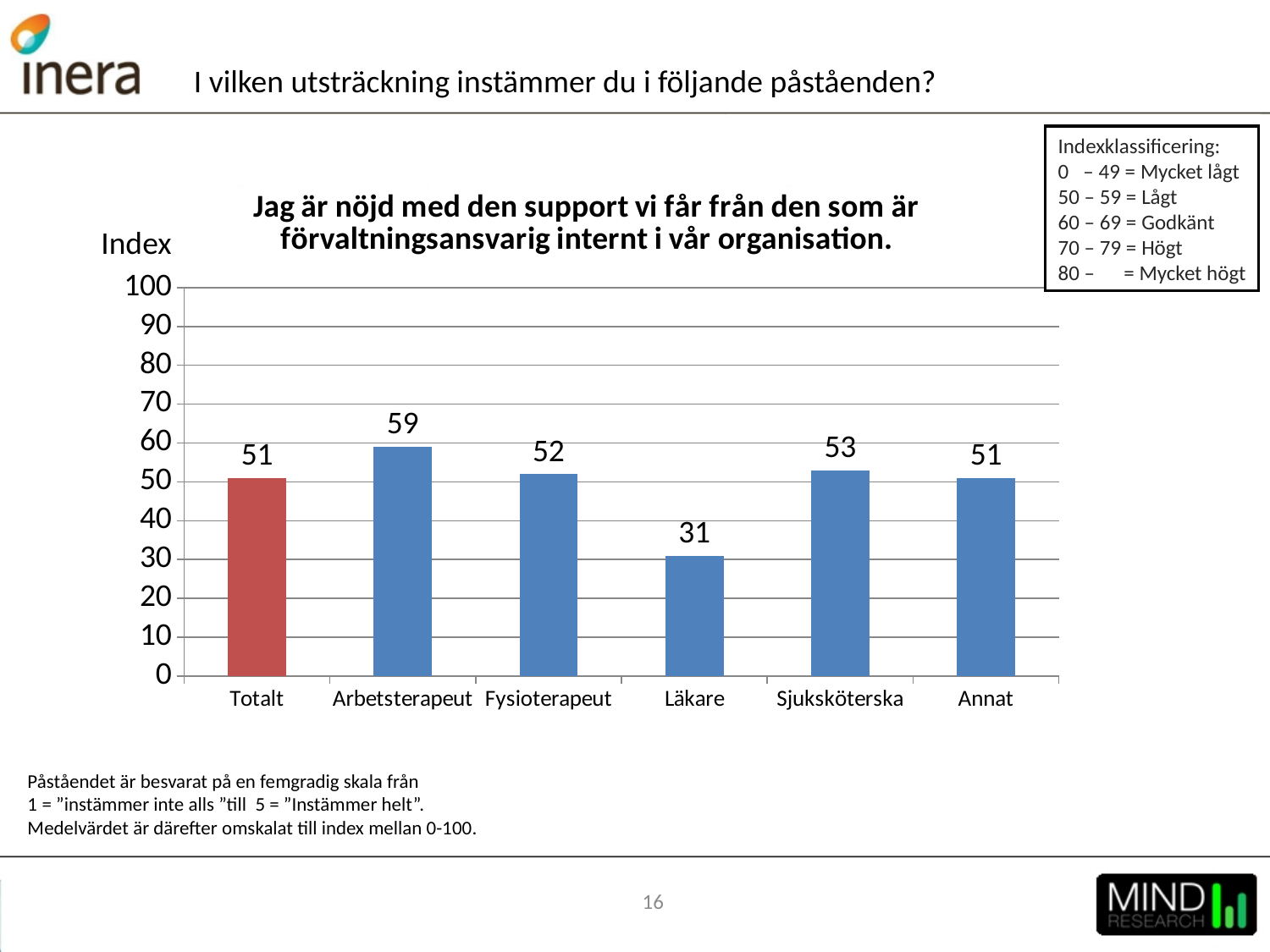
Which has a higher index value, Fysioterapeut or Läkare? Fysioterapeut What is the index value for Arbetsterapeut? 59 What is the difference between the index values for Sjuksköterska and Fysioterapeut? 1 Which category has the highest index value? Arbetsterapeut What is the difference between the index values for Arbetsterapeut and Läkare? 28 Which category has the lowest index value? Läkare What is the index value for Totalt? 51 What is the index value for Läkare? 31 What is the index value for Sjuksköterska? 53 What kind of chart is shown on the slide? Bar chart How many categories are shown on the x axis? 6 Which bar is shown in a different colour (red) from the others? Totalt